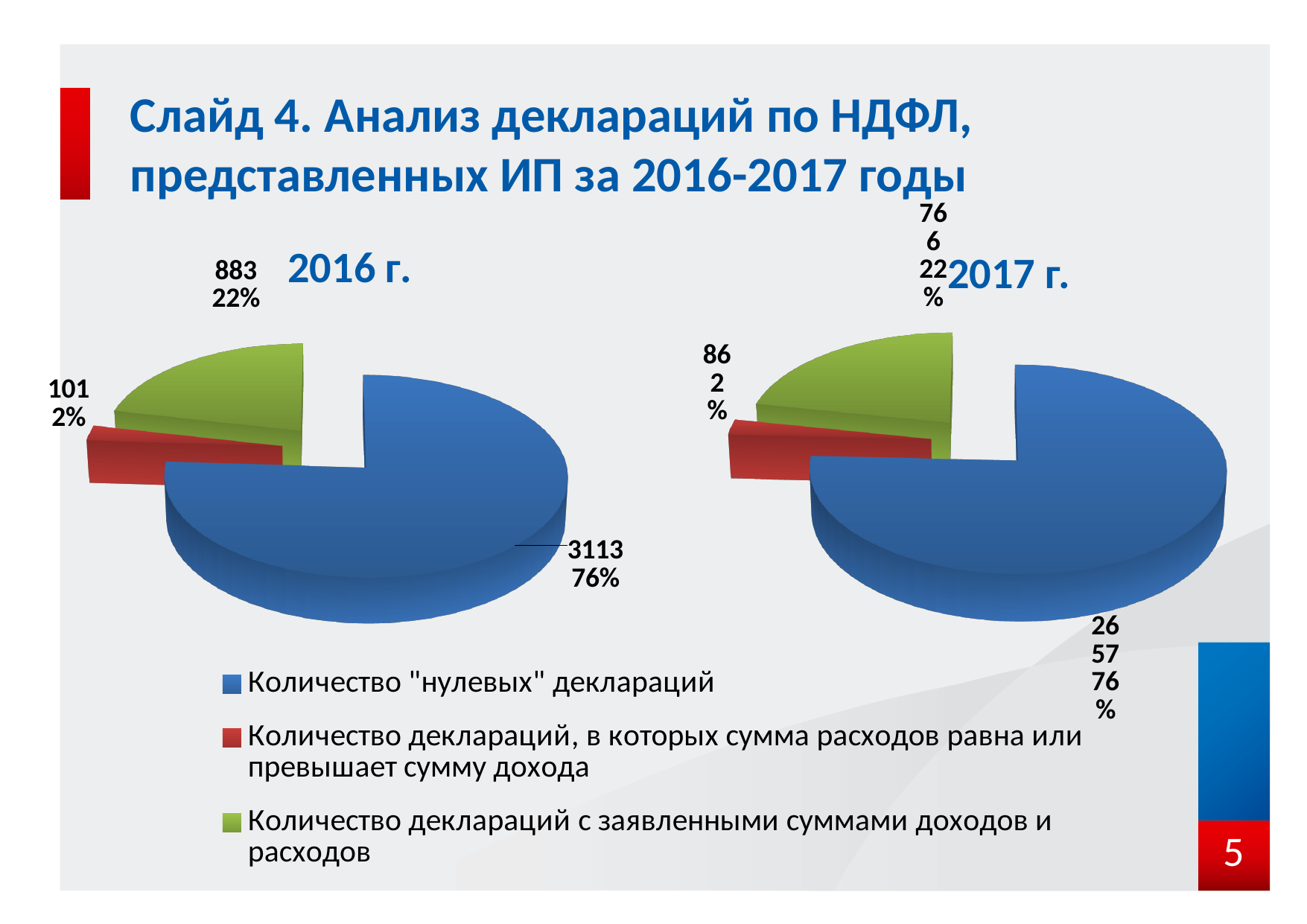
What colour is the slice for Количество "нулевых" деклараций? Blue What kind of chart is used on this slide? Pie chart On the 2016 г. pie chart, which category has the smallest slice? Количество деклараций, в которых сумма расходов равна или превышает сумму дохода On the 2017 г. pie chart, what is the value for Количество деклараций, в которых сумма расходов равна или превышает сумму дохода? 86 On the 2017 г. pie chart, which is larger: the slice for Количество деклараций с заявленными суммами доходов и расходов or the slice for Количество деклараций, в которых сумма расходов равна или превышает сумму дохода? Количество деклараций с заявленными суммами доходов и расходов On the 2016 г. pie chart, what is the value for Количество деклараций, в которых сумма расходов равна или превышает сумму дохода? 101 On the 2016 г. pie chart, which category has the largest slice? Количество "нулевых" деклараций On the 2016 г. pie chart, what is the value for Количество "нулевых" деклараций? 3113 On the 2016 г. pie chart, what is the difference between the value for Количество "нулевых" деклараций and the value for Количество деклараций с заявленными суммами доходов и расходов? 2230 On the 2017 г. pie chart, what share of the pie is Количество "нулевых" деклараций? 76% On the 2016 г. pie chart, what share of the pie is Количество деклараций с заявленными суммами доходов и расходов? 22% How many categories does the legend list? 3